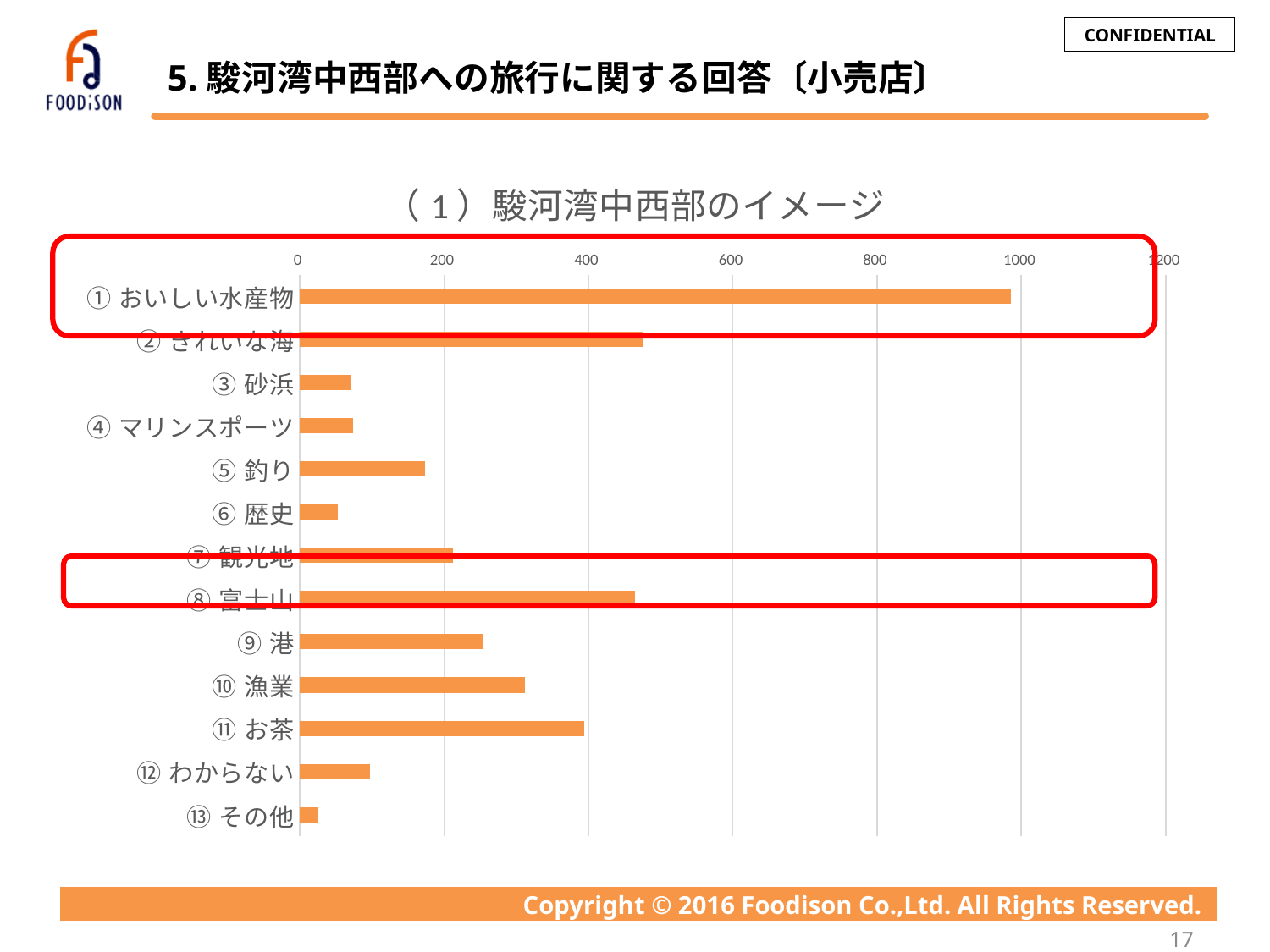
What is the title of the chart? （１）駿河湾中西部のイメージ Is the value for ⑤ 釣り greater or less than 200? less Is the value for ① おいしい水産物 greater or less than 800? greater What kind of chart is shown on the slide? bar chart Which has the larger value, ⑪ お茶 or ⑩ 漁業? ⑪ お茶 Is the value for ⑫ わからない greater or less than 200? less Which category has the lowest value in the chart? ⑬ その他 Which category has the highest value in the chart? ① おいしい水産物 Which has the larger value, ⑦ 観光地 or ⑥ 歴史? ⑦ 観光地 How many categories are plotted in the chart? 13